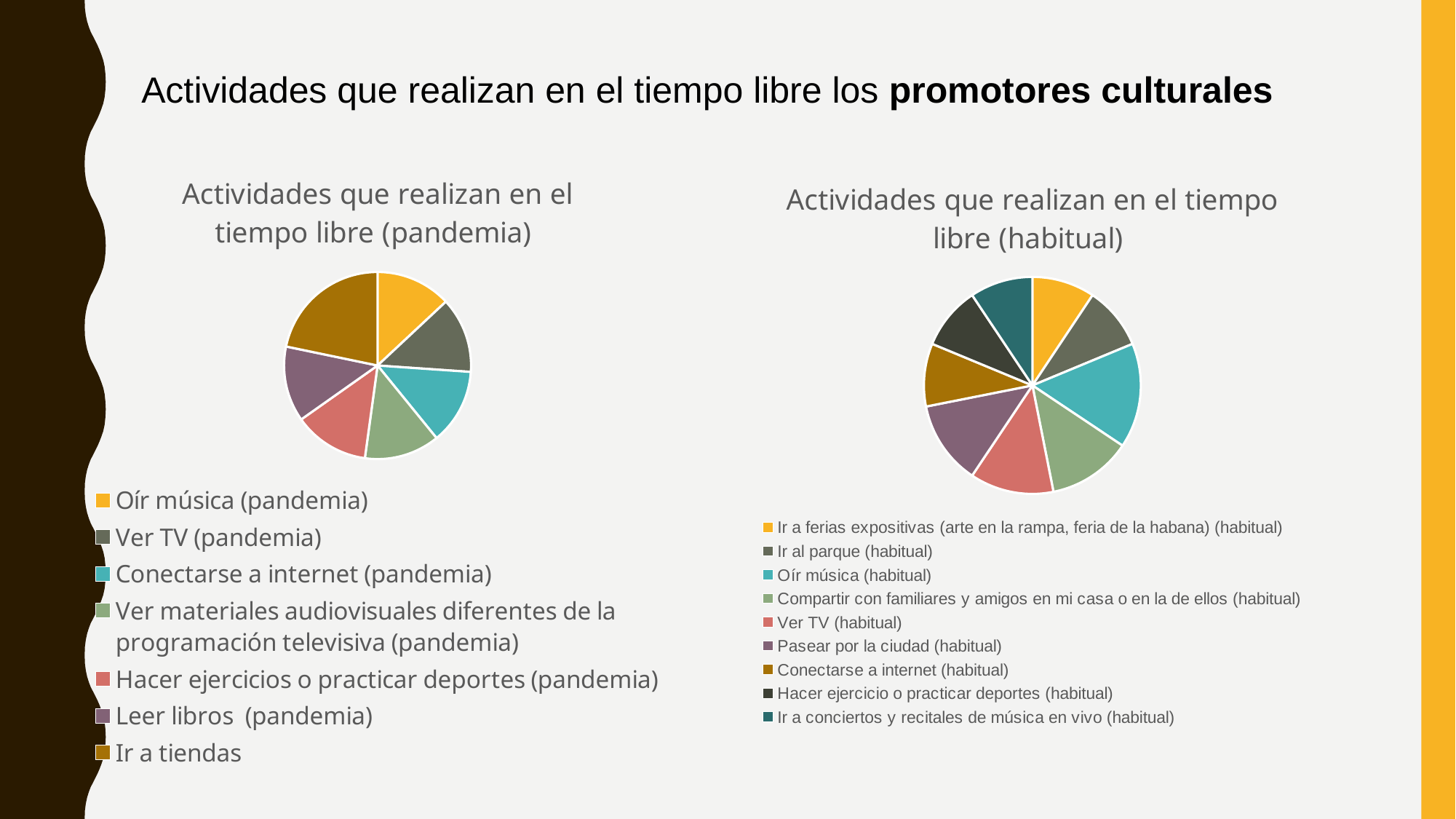
What kind of chart is the left chart titled 'Actividades que realizan en el tiempo libre (pandemia)'? pie chart How many entries does the legend of the left chart (pandemia) list? 7 In the left chart (pandemia), which activity has the largest slice? Ir a tiendas How many entries does the legend of the right chart (habitual) list? 9 In the left chart (pandemia), what colour is the slice for 'Conectarse a internet (pandemia)'? teal In the right chart (habitual), how many slices does the pie have? 9 In the left chart (pandemia), which slice is larger: 'Ir a tiendas' or 'Oír música (pandemia)'? Ir a tiendas In the right chart (habitual), which slice is larger: 'Compartir con familiares y amigos en mi casa o en la de ellos (habitual)' or 'Ir al parque (habitual)'? Compartir con familiares y amigos en mi casa o en la de ellos (habitual) What kind of chart is the right chart titled 'Actividades que realizan en el tiempo libre (habitual)'? pie chart In the left chart (pandemia), how many slices does the pie have? 7 What is the title of the right chart? Actividades que realizan en el tiempo libre (habitual) In the right chart (habitual), which slice is larger: 'Oír música (habitual)' or 'Ir a ferias expositivas (arte en la rampa, feria de la habana) (habitual)'? Oír música (habitual)